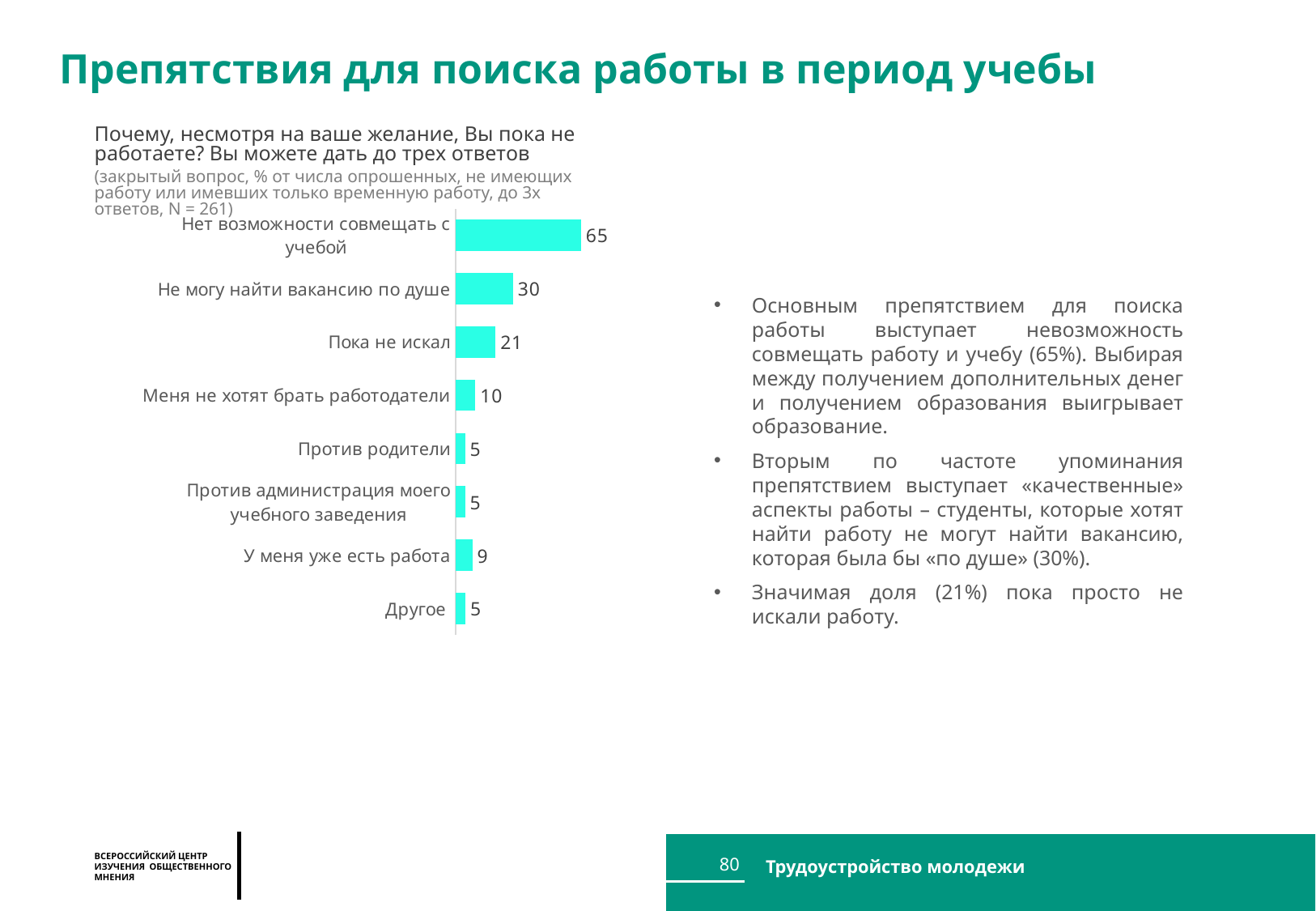
Какое значение указано для категории «Не могу найти вакансию по душе»? 30 Какое значение указано для категории «У меня уже есть работа»? 9 Какое значение указано для категории «Нет возможности совмещать с учебой»? 65 На сколько значение «Нет возможности совмещать с учебой» больше значения «Не могу найти вакансию по душе»? 35 Сколько категорий показано на диаграмме? 8 Какой объём выборки (N) указан в подзаголовке диаграммы? N = 261 Какая категория имеет наибольшее значение на диаграмме? Нет возможности совмещать с учебой Какой тип диаграммы используется на слайде? Столбчатая (bar chart) Сколько категорий на диаграмме имеют значение 5? 3 На сколько значение «Пока не искал» больше значения «Меня не хотят брать работодатели»? 11 Что больше: значение «Меня не хотят брать работодатели» или «У меня уже есть работа»? Меня не хотят брать работодатели Какое значение указано для категории «Пока не искал»? 21